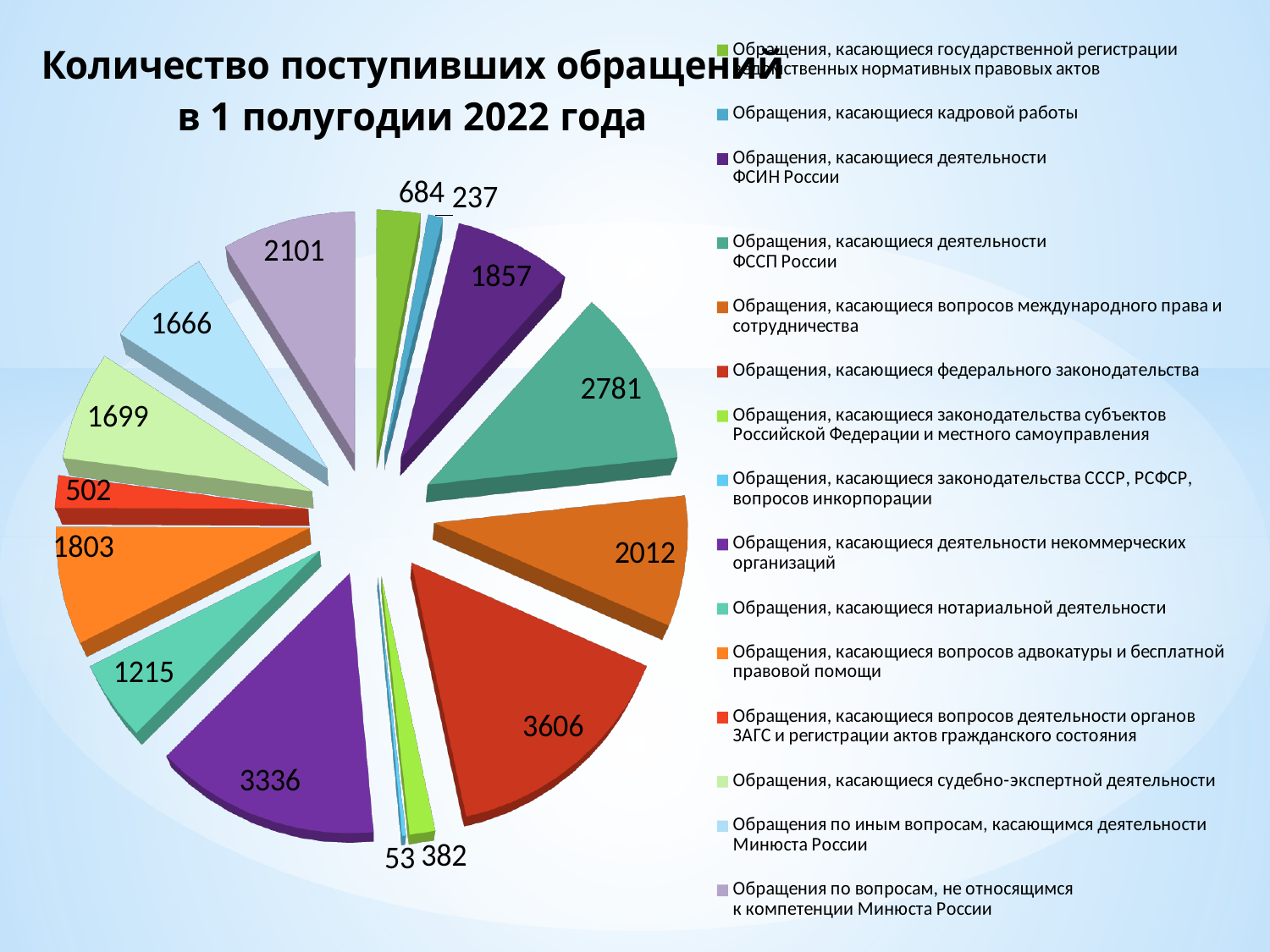
What is the value for 'Обращения по вопросам, не относящимся к компетенции Минюста России'? 2101 What is the value for 'Обращения, касающиеся деятельности ФССП России'? 2781 How many categories does the legend list? 15 What is the difference between the values for 'Обращения, касающиеся деятельности ФССП России' and 'Обращения, касающиеся вопросов международного права и сотрудничества'? 769 What is the difference between the values for 'Обращения, касающиеся федерального законодательства' and 'Обращения, касающиеся деятельности некоммерческих организаций'? 270 What type of chart is shown on the slide? pie chart What is the value for 'Обращения, касающиеся нотариальной деятельности'? 1215 Which category has the highest value? Обращения, касающиеся федерального законодательства What is the title of the chart? Количество поступивших обращений в 1 полугодии 2022 года What is the value for 'Обращения, касающиеся федерального законодательства'? 3606 Which category has the lowest value? Обращения, касающиеся законодательства СССР, РСФСР, вопросов инкорпорации Which is larger: the value for 'Обращения, касающиеся деятельности ФСИН России' or for 'Обращения, касающиеся вопросов международного права и сотрудничества'? Обращения, касающиеся вопросов международного права и сотрудничества